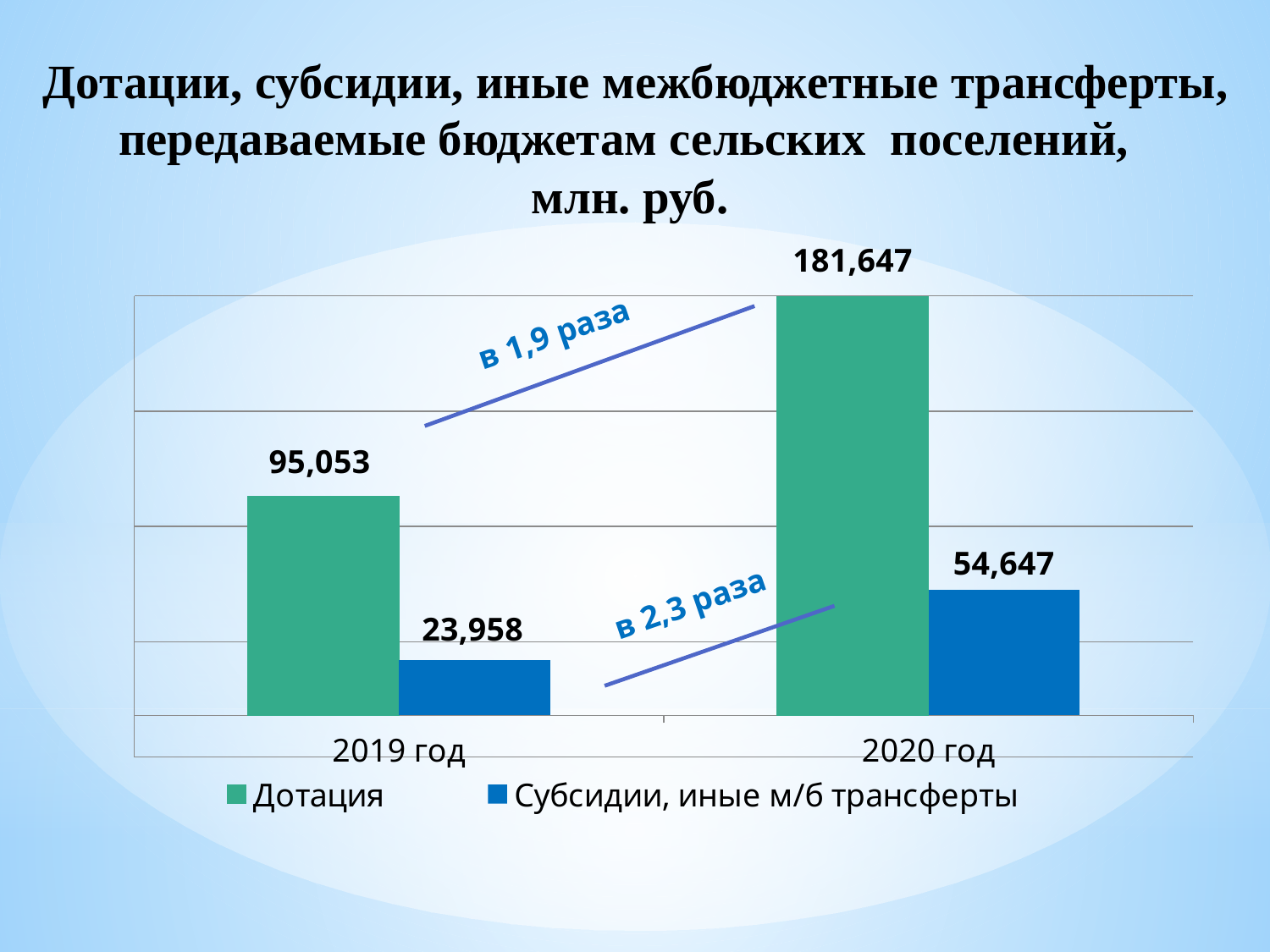
What is the value for Дотация in 2019 год? 95,053 What kind of chart is shown on the slide? Bar chart What is the value for Субсидии, иные м/б трансферты in 2020 год? 54,647 Which bar has the highest value on the chart? Дотация, 2020 год What is the value for Дотация in 2020 год? 181,647 Which bar has the lowest value on the chart? Субсидии, иные м/б трансферты, 2019 год According to the annotation on the chart, by what factor did Дотация grow from 2019 год to 2020 год? в 1,9 раза Which is larger in 2020 год: Дотация or Субсидии, иные м/б трансферты? Дотация What is the difference between the Дотация values for 2020 год and 2019 год? 86,594 What is the difference between the Субсидии, иные м/б трансферты values for 2020 год and 2019 год? 30,689 What is the value for Субсидии, иные м/б трансферты in 2019 год? 23,958 How many series does the legend list? 2